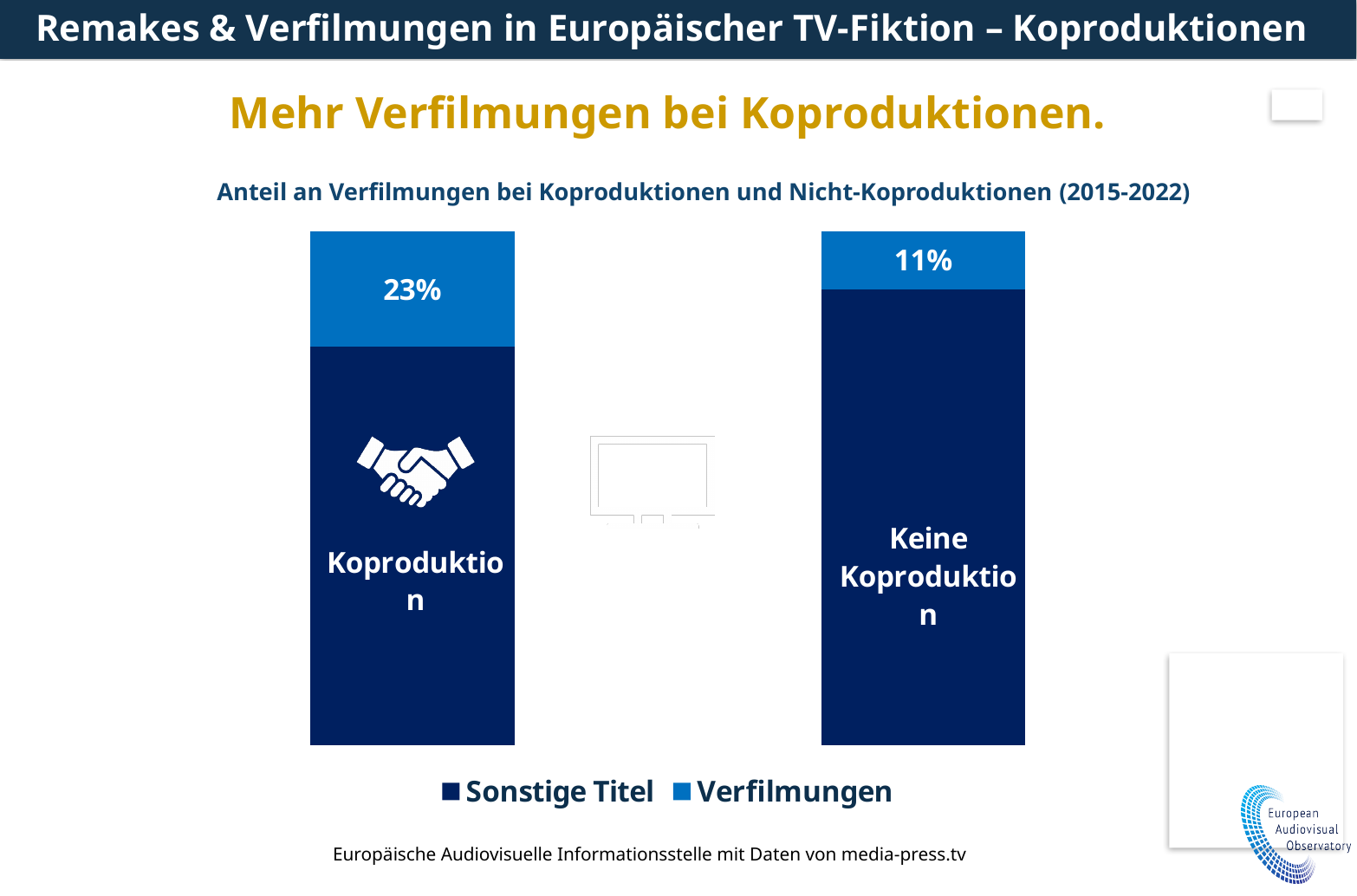
What share of Verfilmungen is shown for Koproduktion? 23% Which series does the light blue colour represent in the legend? Verfilmungen Is the Verfilmungen share larger for Koproduktion or for Keine Koproduktion? Koproduktion Which category has the higher share of Verfilmungen? Koproduktion How many series does the legend list? 2 Which category has the lower share of Verfilmungen? Keine Koproduktion How many categories are shown in the chart? 2 What share of Verfilmungen is shown for Keine Koproduktion? 11% What is the title of the chart? Anteil an Verfilmungen bei Koproduktionen und Nicht-Koproduktionen (2015-2022) What kind of chart is shown on the slide? Stacked bar chart What is the difference in the Verfilmungen share between Koproduktion and Keine Koproduktion? 12%